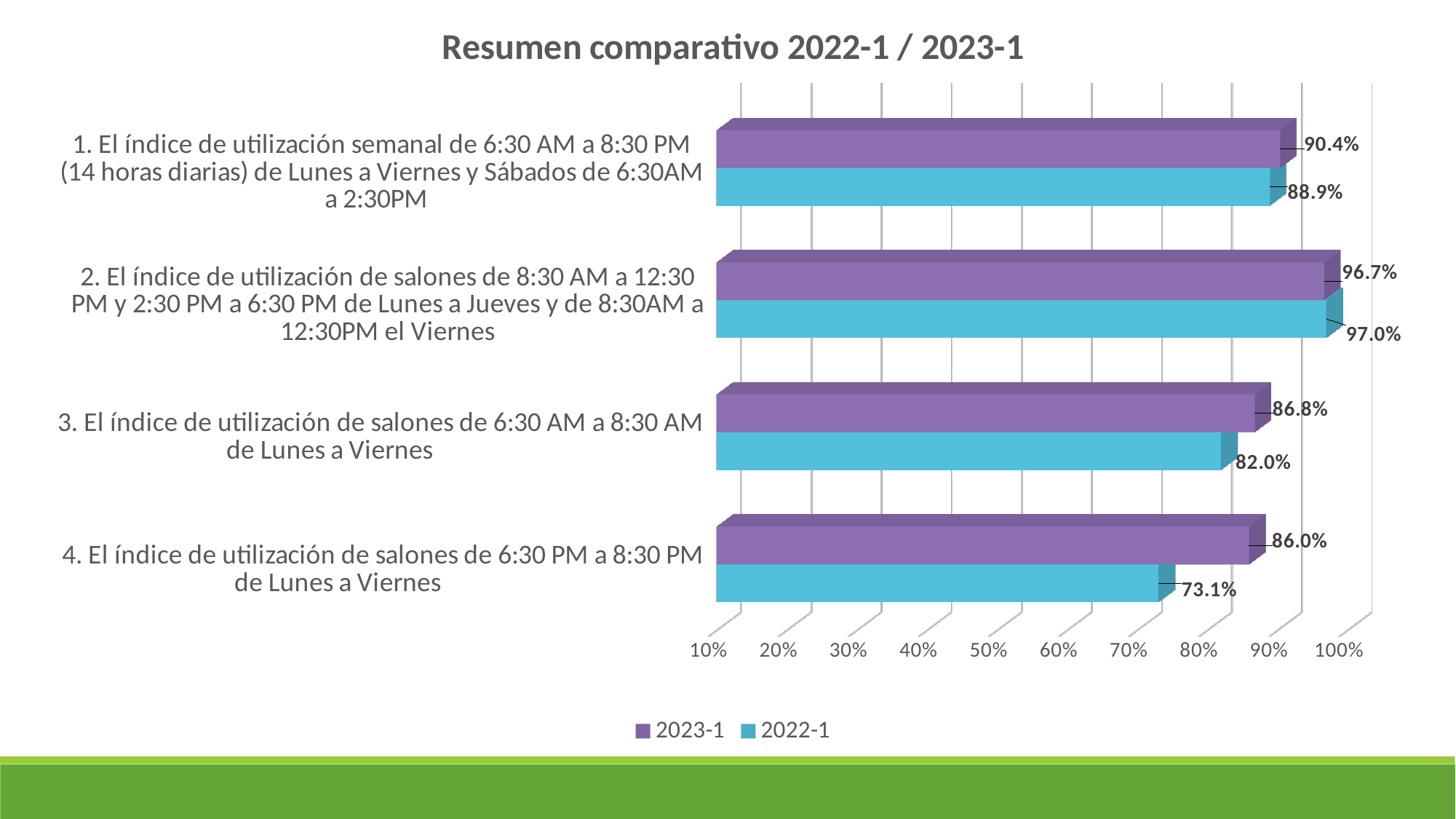
Which category has the highest 2023-1 value? 2. El índice de utilización de salones de 8:30 AM a 12:30 PM y 2:30 PM a 6:30 PM de Lunes a Jueves y de 8:30AM a 12:30PM el Viernes What is the difference between the 2023-1 and 2022-1 values for category 4 (6:30 PM a 8:30 PM de Lunes a Viernes)? 12.9% How many series does the legend list? 2 What type of chart is shown on the slide? Bar chart What is the 2022-1 value for category 4 (El índice de utilización de salones de 6:30 PM a 8:30 PM de Lunes a Viernes)? 73.1% Which category has the lowest 2022-1 value? 4. El índice de utilización de salones de 6:30 PM a 8:30 PM de Lunes a Viernes For category 2 (8:30 AM a 12:30 PM y 2:30 PM a 6:30 PM), which series has the larger value, 2023-1 or 2022-1? 2022-1 What is the difference between the 2023-1 and 2022-1 values for category 3 (6:30 AM a 8:30 AM de Lunes a Viernes)? 4.8% What is the 2022-1 value for category 2 (El índice de utilización de salones de 8:30 AM a 12:30 PM y 2:30 PM a 6:30 PM)? 97.0% How many categories are shown in the chart? 4 What is the 2023-1 value for category 1 (El índice de utilización semanal de 6:30 AM a 8:30 PM)? 90.4% For category 1 (El índice de utilización semanal), which series has the larger value, 2023-1 or 2022-1? 2023-1